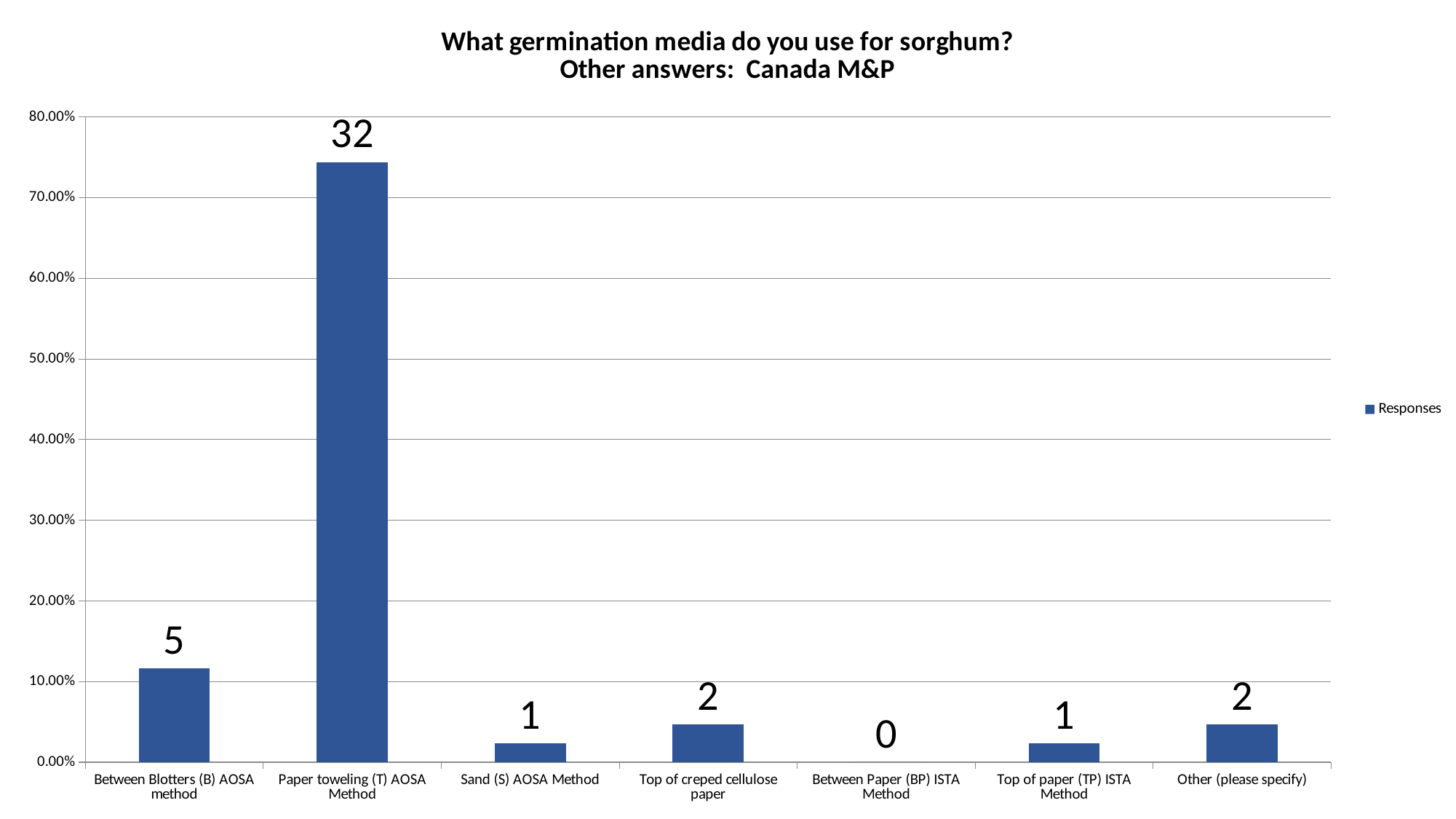
How many categories are shown on the x axis? 7 Is the bar for Between Blotters (B) AOSA method greater or less than 10.00%? greater Which category has the lowest number of responses? Between Paper (BP) ISTA Method What is the difference between the data labels for Paper toweling (T) AOSA Method and Between Blotters (B) AOSA method? 27 Which has more responses, Top of creped cellulose paper or Sand (S) AOSA Method? Top of creped cellulose paper What is the data label shown for Between Paper (BP) ISTA Method? 0 What is the data label shown for Other (please specify)? 2 What kind of chart is shown on the slide? Bar chart What is the data label shown for Paper toweling (T) AOSA Method? 32 Is the bar for Paper toweling (T) AOSA Method greater or less than 70.00%? greater Which category has the highest number of responses? Paper toweling (T) AOSA Method What is the data label shown for Between Blotters (B) AOSA method? 5